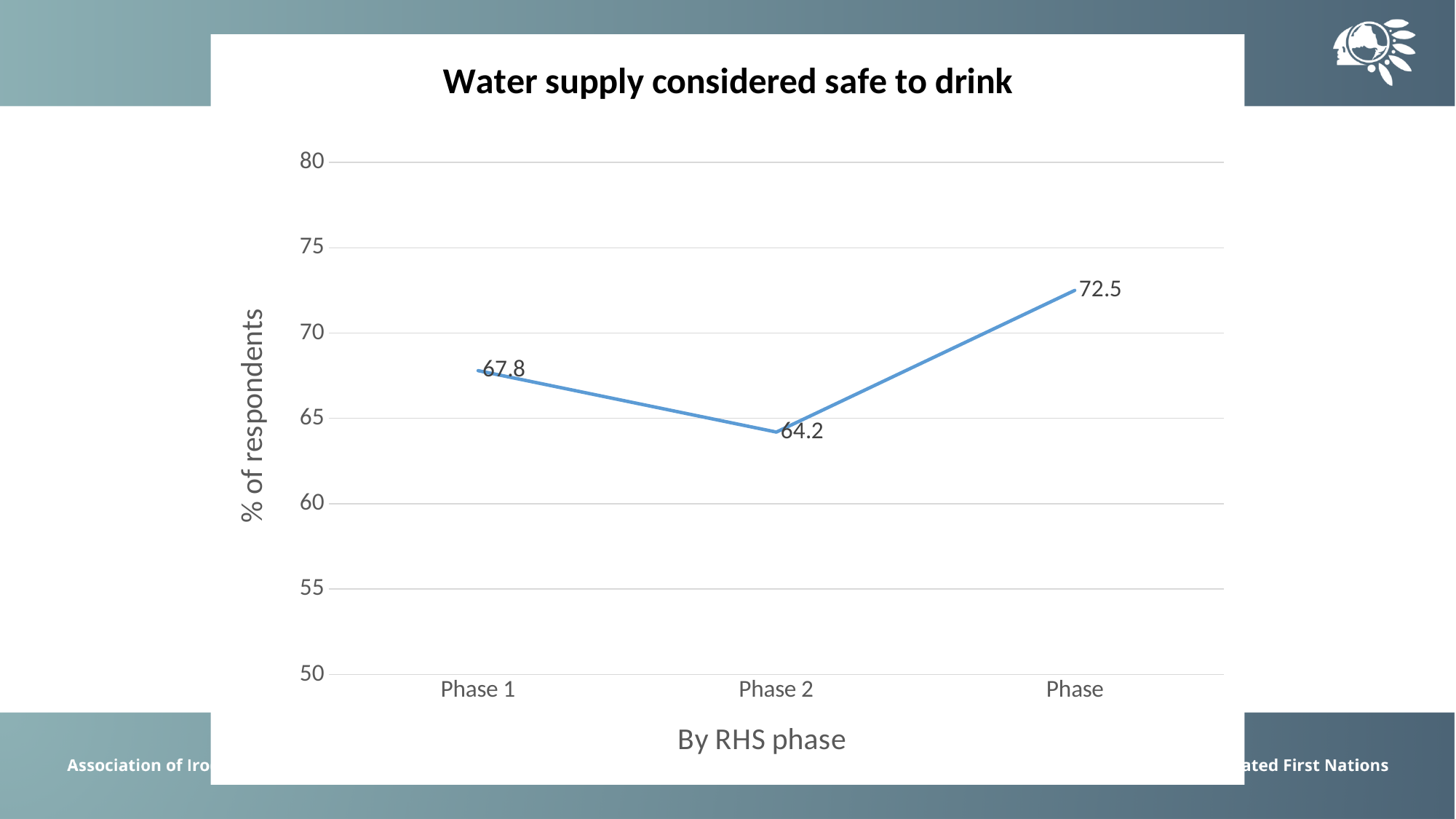
What is the value for Phase 1? 67.8 Which phase has the lowest value? Phase 2 What is the difference between the values for Phase 1 and Phase 2? 3.6 Is the value for Phase 2 greater or less than 65? less How many data points are plotted on the line? 3 What is the value of the rightmost (third) point on the line? 72.5 What is the value for Phase 2? 64.2 Which is larger, the value for Phase 1 or Phase 2? Phase 1 What is the difference between the rightmost point (72.5) and Phase 2? 8.3 What is the label of the vertical axis? % of respondents Which point on the line has the highest value? The rightmost (third) point, 72.5 What kind of chart is shown on the slide? Line chart